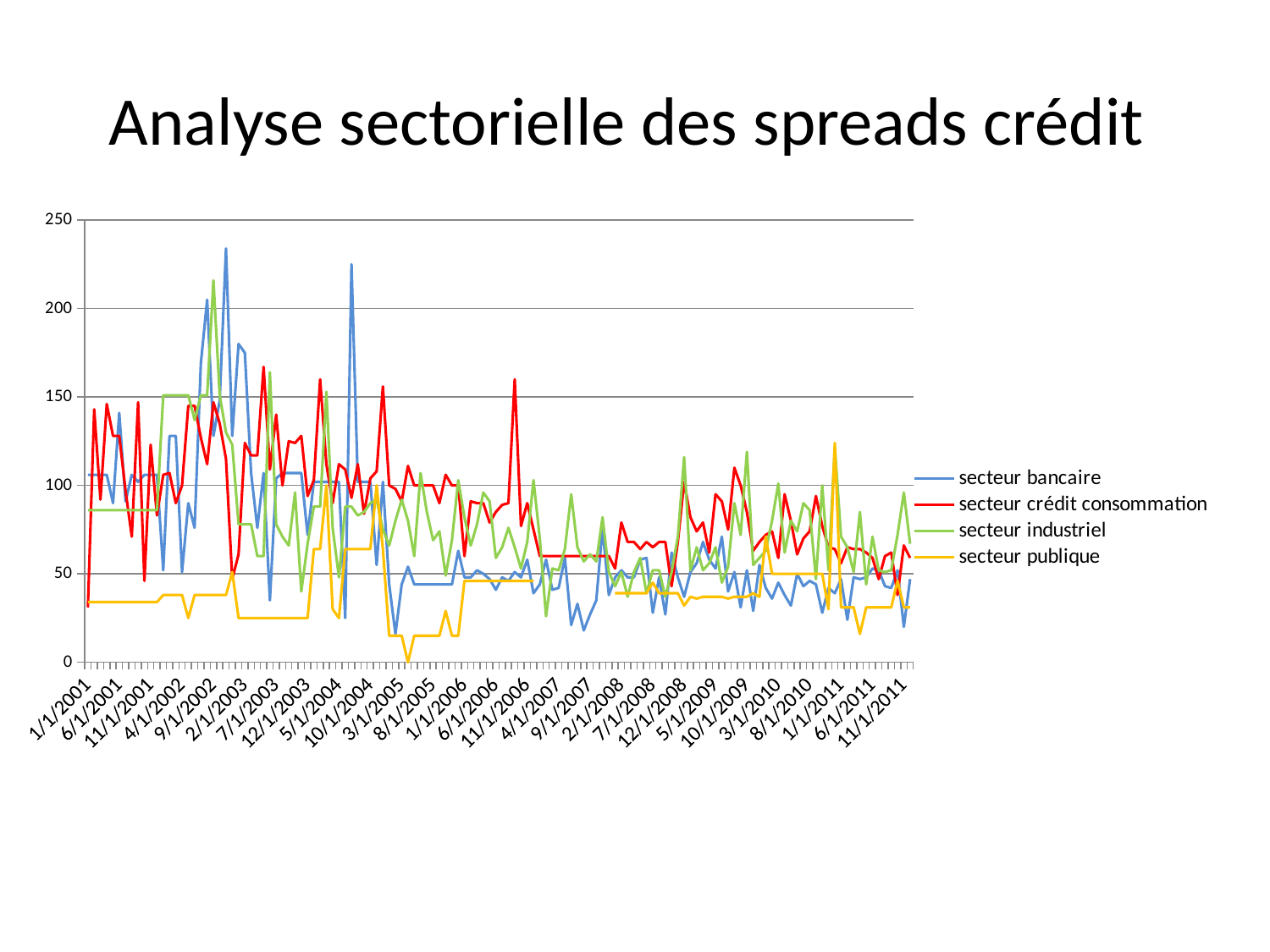
What kind of chart is shown on the slide? line chart What is the first date label on the horizontal axis? 1/1/2001 What is the last date label on the horizontal axis? 11/1/2011 What is the highest value shown on the vertical axis? 250 Which series stays lowest for most of the period shown? secteur publique Is the peak value of secteur bancaire around 2/1/2003 greater or less than 200? greater Overall, do the values for secteur crédit consommation rise or fall from 2001 to 2011? fall Which series is drawn in blue? secteur bancaire Which series reaches the highest value anywhere on the chart? secteur bancaire How many series does the legend list? 4 Is the value for secteur publique around 3/1/2005 greater or less than 50? less What is the title of the chart? Analyse sectorielle des spreads crédit